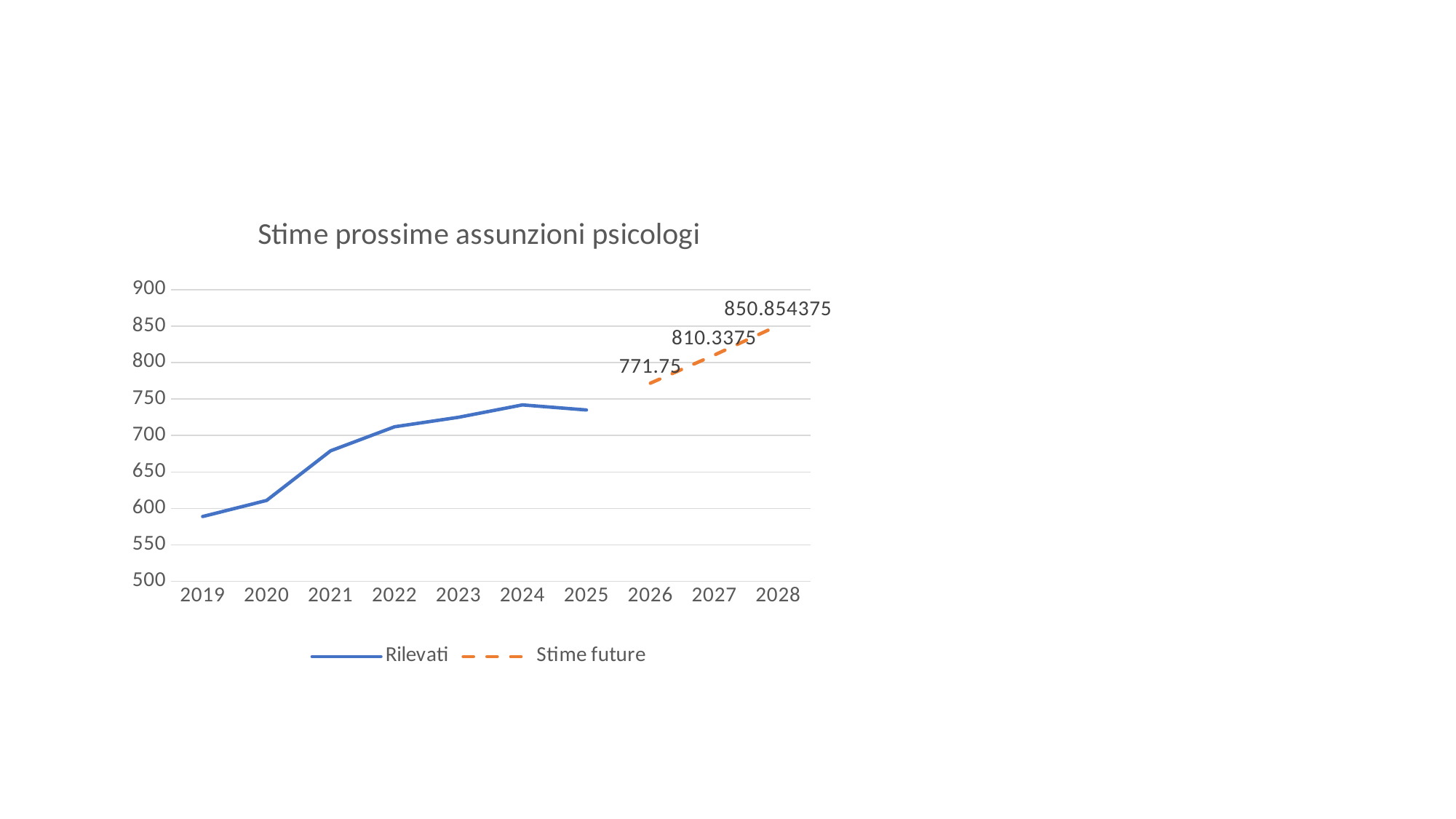
What is the title of the chart? Stime prossime assunzioni psicologi Which year has the lowest Rilevati value? 2019 How many series does the legend list? 2 Is the Rilevati value for 2024 greater or less than 700? greater Is the Rilevati value for 2019 greater or less than 600? less What is the value of Stime future for 2028? 850.854375 Is the Rilevati value for 2021 greater or less than 700? less What kind of chart is shown on the slide? line chart What are the names of the two series in the legend? Rilevati and Stime future How many years are shown on the x axis? 10 What is the value of Stime future for 2027? 810.3375 What is the value of Stime future for 2026? 771.75